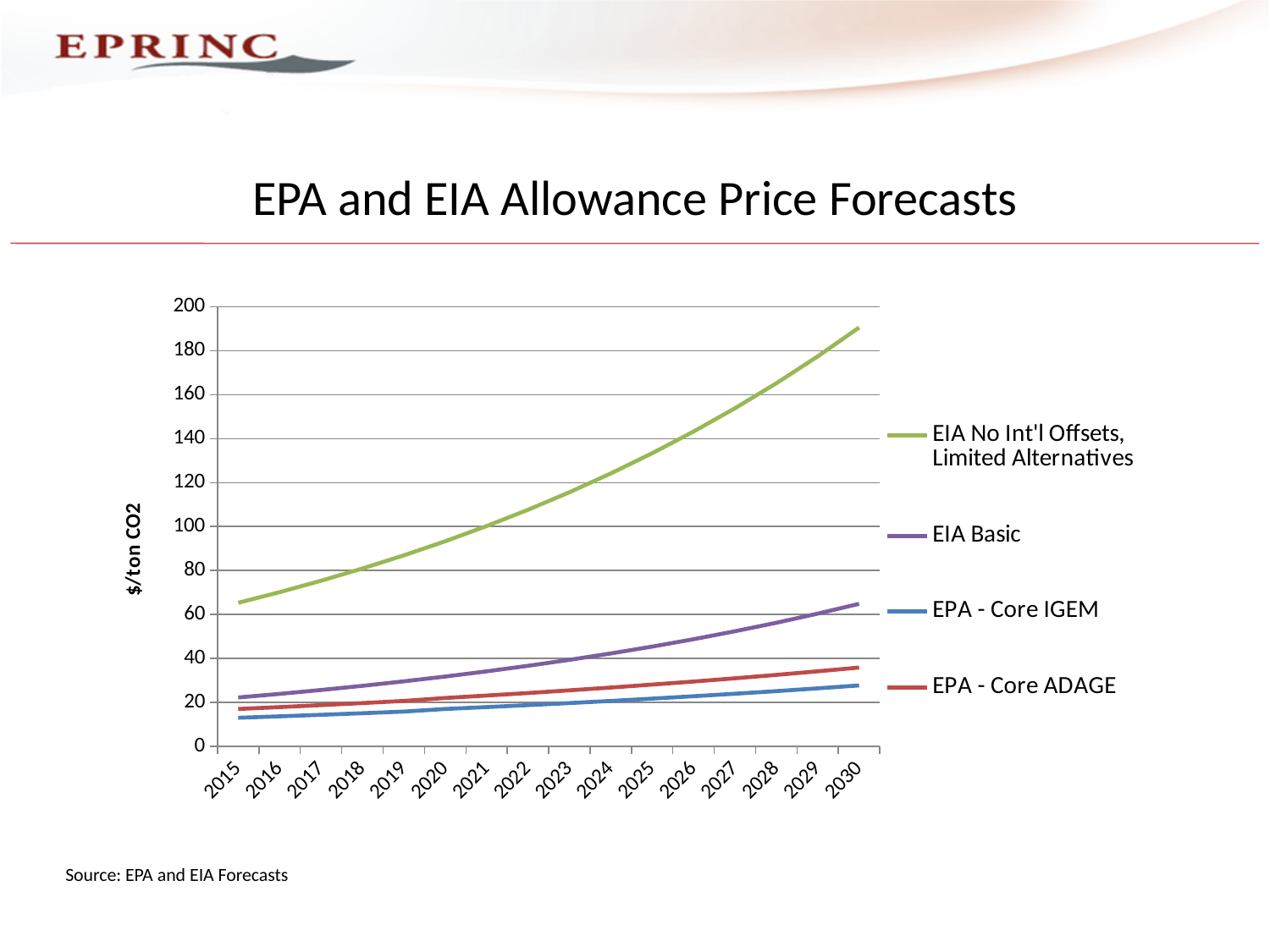
Is the value for EIA No Int'l Offsets, Limited Alternatives in 2015 greater or less than 60? greater In 2030, which is larger: EIA Basic or EPA - Core ADAGE? EIA Basic Does the EIA No Int'l Offsets, Limited Alternatives series rise or fall from 2015 to 2030? rise How many series does the legend list? 4 Is the value for EIA No Int'l Offsets, Limited Alternatives in 2030 greater or less than 180? greater Which series has the lowest value in 2015? EPA - Core IGEM What is the label on the y axis? $/ton CO2 Which series has the highest value in 2030? EIA No Int'l Offsets, Limited Alternatives How many years are shown along the x axis? 16 Is the value for EIA Basic in 2030 greater or less than 60? greater What kind of chart is shown on the slide? line chart